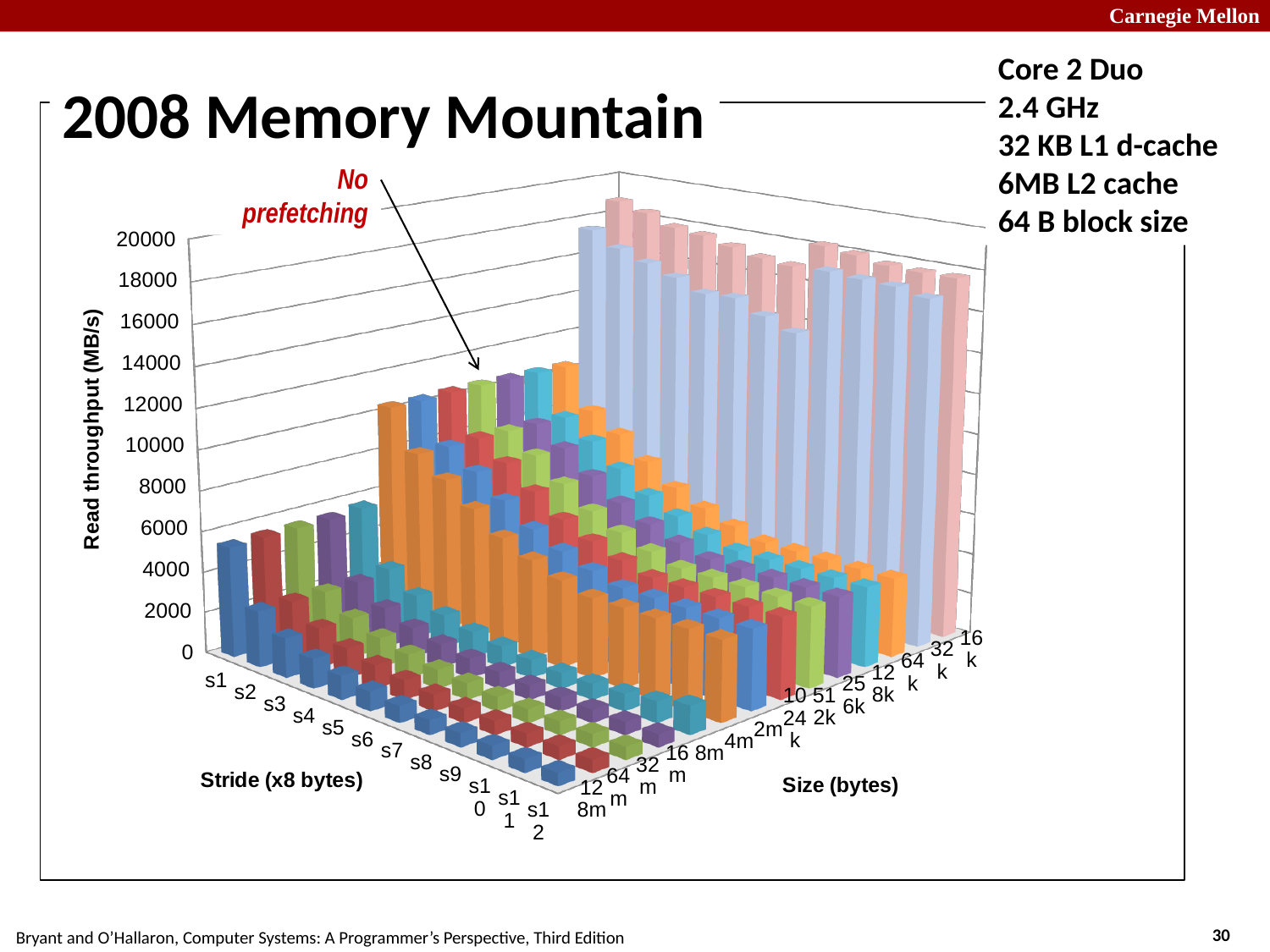
Is the read throughput for stride s1 at size 16k greater or less than 14000? greater Which is larger: the read throughput for stride s1 at size 16k or at size 128m? 16k Is the read throughput for stride s1 at size 128m greater or less than 10000? less What is the title of the chart? 2008 Memory Mountain Is the read throughput for stride s12 at size 128m greater or less than 4000? less How many size categories are shown along the size axis? 14 At size 128m, which stride has the highest read throughput? s1 At size 128m, does read throughput rise or fall as the stride increases from s1 to s12? fall How many stride categories are shown along the stride axis? 12 For stride s1, does read throughput rise or fall as the size decreases from 128m to 16k? rise What is the label of the vertical axis? Read throughput (MB/s) What kind of chart is shown on the slide? bar chart